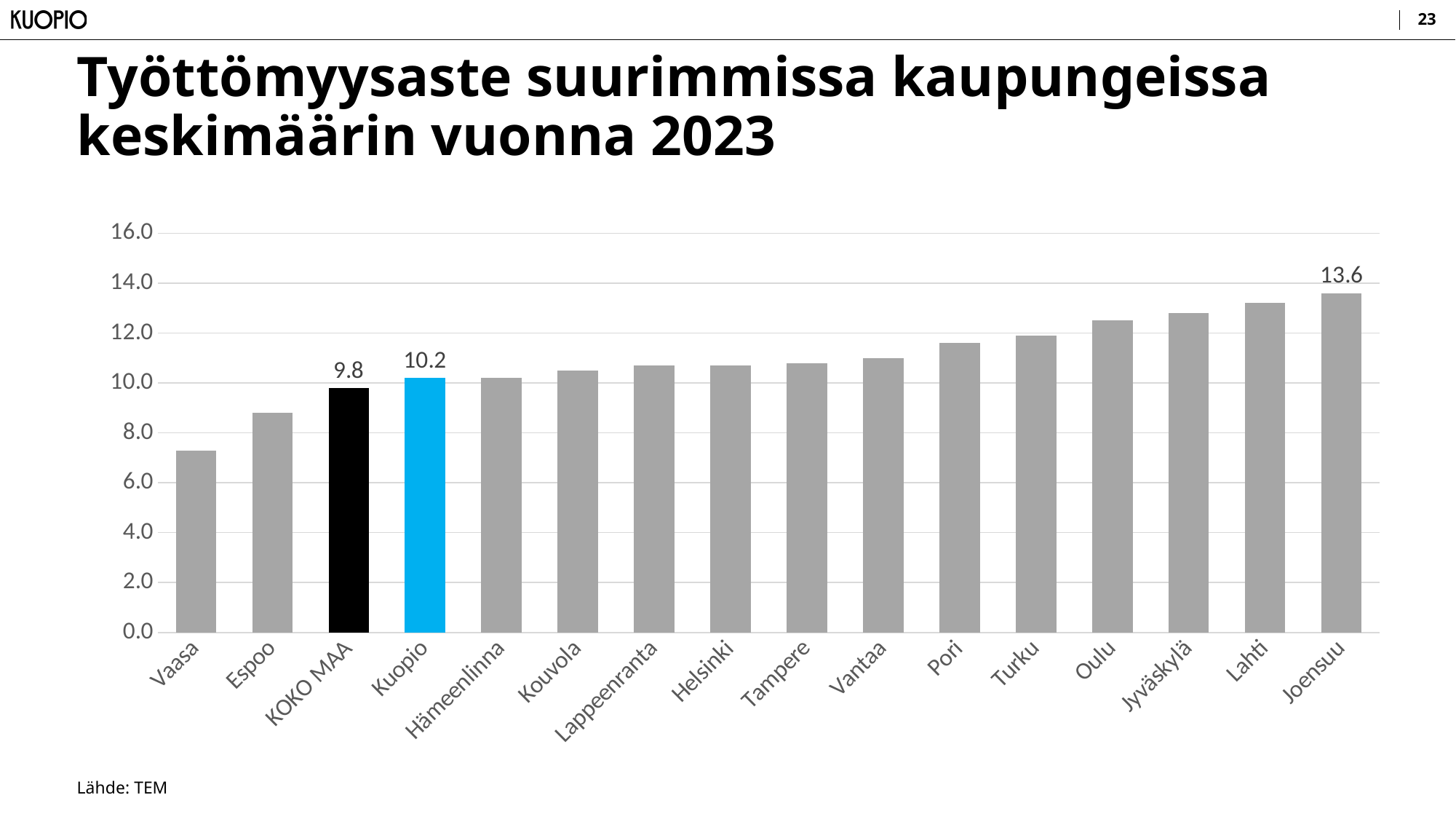
Which is larger, the value for Kuopio or the value for KOKO MAA? Kuopio Is the value for Lahti greater or less than 12.0? greater How many categories are shown on the x axis? 16 Which category has the highest value? Joensuu What is the value for Kuopio? 10.2 What is the difference between the values for Kuopio and KOKO MAA? 0.4 Is the value for Vaasa greater or less than 8.0? less Do the values generally rise or fall from left to right along the x axis? rise Which category has the lowest value? Vaasa What is the difference between the values for Joensuu and Kuopio? 3.4 What is the value for KOKO MAA? 9.8 What is the value for Joensuu? 13.6